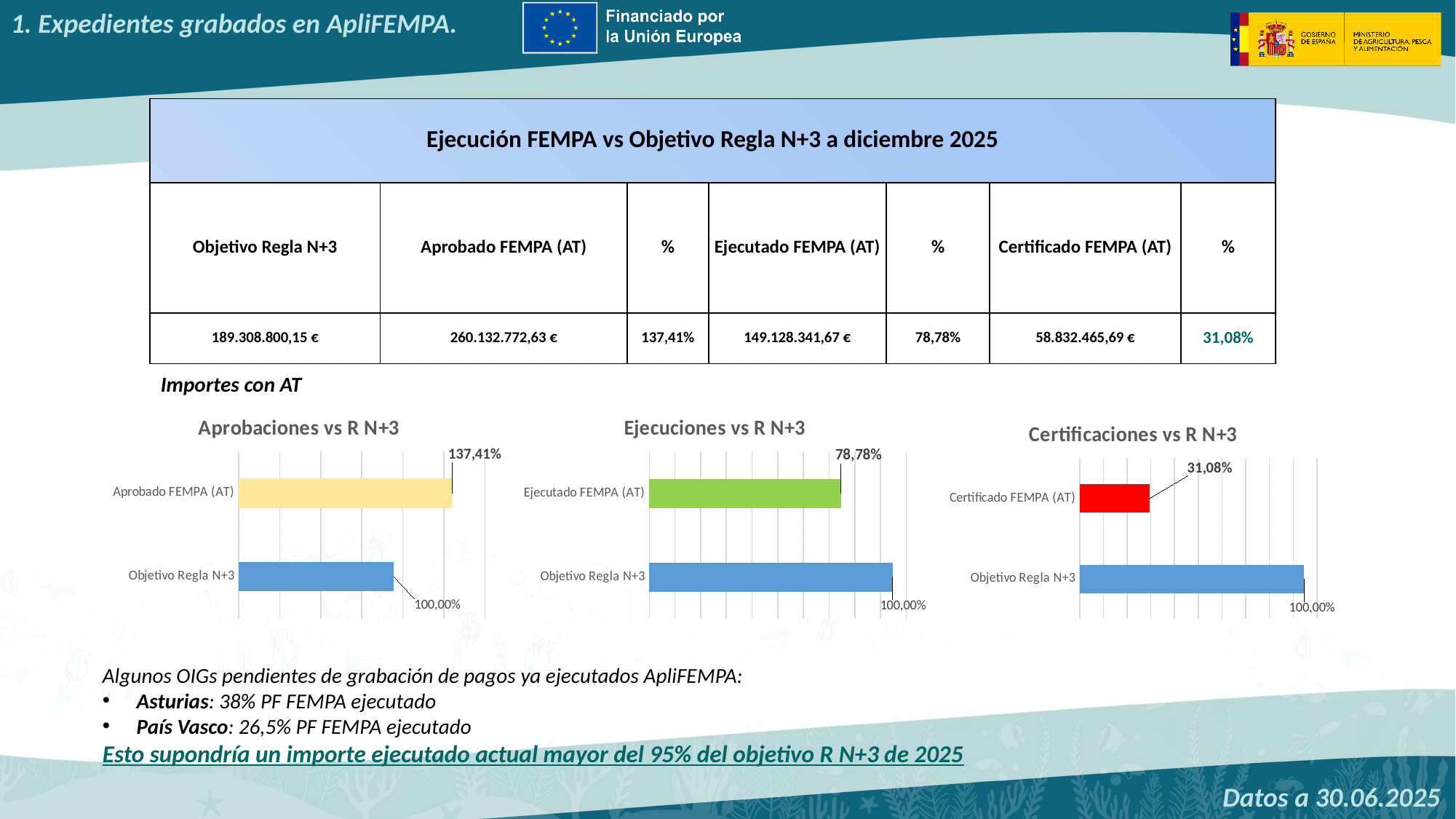
In the 'Ejecuciones vs R N+3' chart, what is the difference between Objetivo Regla N+3 and Ejecutado FEMPA (AT)? 21,22% In the 'Certificaciones vs R N+3' chart, what is the value for Certificado FEMPA (AT)? 31,08% In the 'Aprobaciones vs R N+3' chart, what is the value for Aprobado FEMPA (AT)? 137,41% In the 'Certificaciones vs R N+3' chart, which is larger: Certificado FEMPA (AT) or Objetivo Regla N+3? Objetivo Regla N+3 In the 'Ejecuciones vs R N+3' chart, which category has the lowest value? Ejecutado FEMPA (AT) In the 'Certificaciones vs R N+3' chart, what is the difference between Objetivo Regla N+3 and Certificado FEMPA (AT)? 68,92% How many categories are shown in the 'Certificaciones vs R N+3' chart? 2 In the 'Aprobaciones vs R N+3' chart, which category has the highest value? Aprobado FEMPA (AT) In the 'Ejecuciones vs R N+3' chart, what is the value for Ejecutado FEMPA (AT)? 78,78% In the 'Aprobaciones vs R N+3' chart, what is the difference between Aprobado FEMPA (AT) and Objetivo Regla N+3? 37,41% In the 'Certificaciones vs R N+3' chart, what is the value for Objetivo Regla N+3? 100,00% What kind of chart is 'Ejecuciones vs R N+3'? Bar chart